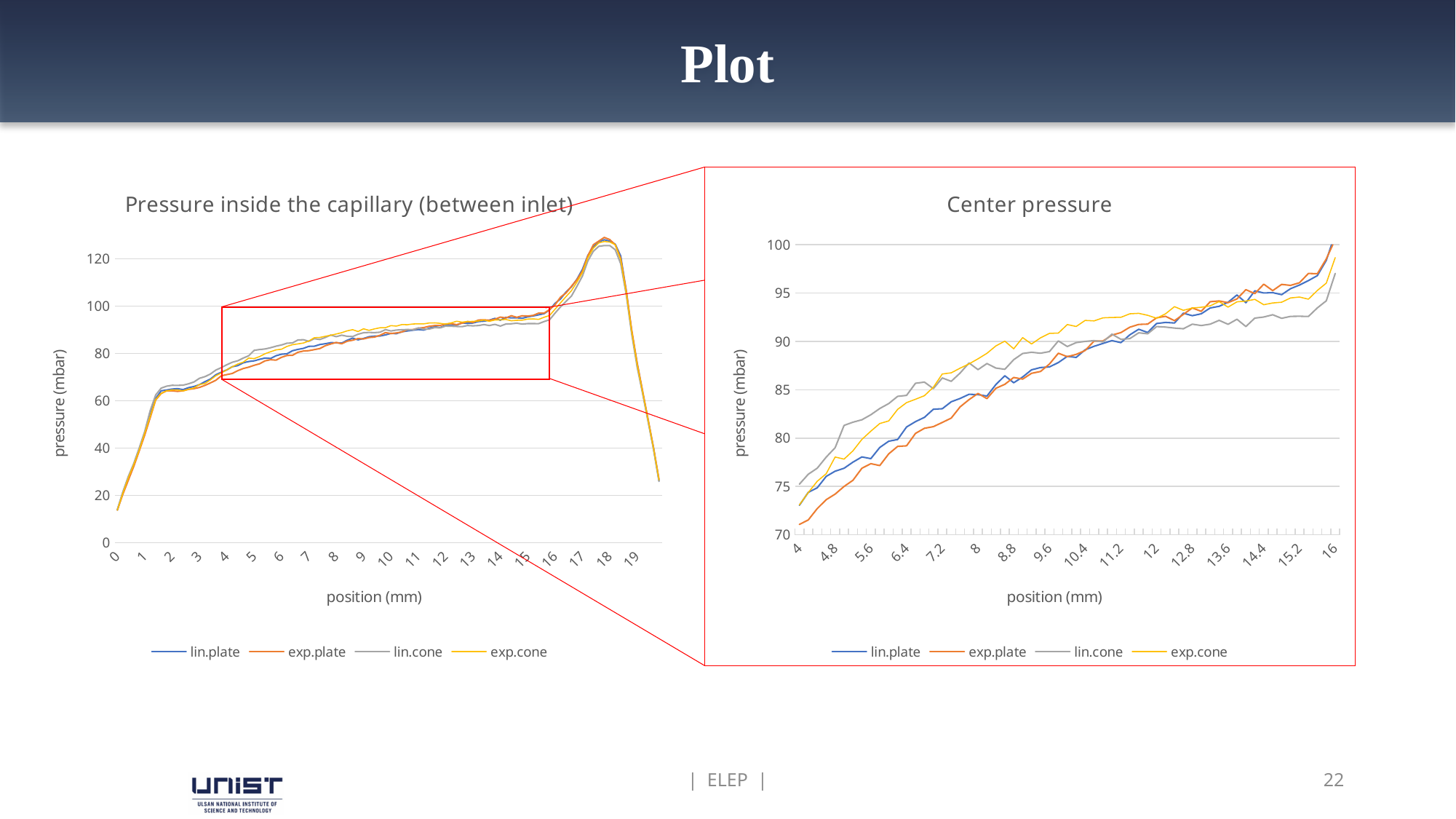
In the 'Center pressure' chart, do the pressure values generally rise or fall as position increases from 4 to 16? rise What is the y-axis label of the 'Pressure inside the capillary (between inlet)' chart? pressure (mbar) In the 'Pressure inside the capillary (between inlet)' chart, is the peak value of the lines near position 18 greater or less than 120? greater What kind of chart is the 'Pressure inside the capillary (between inlet)' chart? line chart In the 'Pressure inside the capillary (between inlet)' chart, is the value of the lines at position 0 greater or less than 20? less In the 'Center pressure' chart, is the lin.plate value at position 16 greater or less than 95? greater How many series does the legend of the 'Center pressure' chart list? 4 What kind of chart is the 'Center pressure' chart? line chart In the 'Center pressure' chart, which series is drawn in yellow? exp.cone How many series does the legend of the 'Pressure inside the capillary (between inlet)' chart list? 4